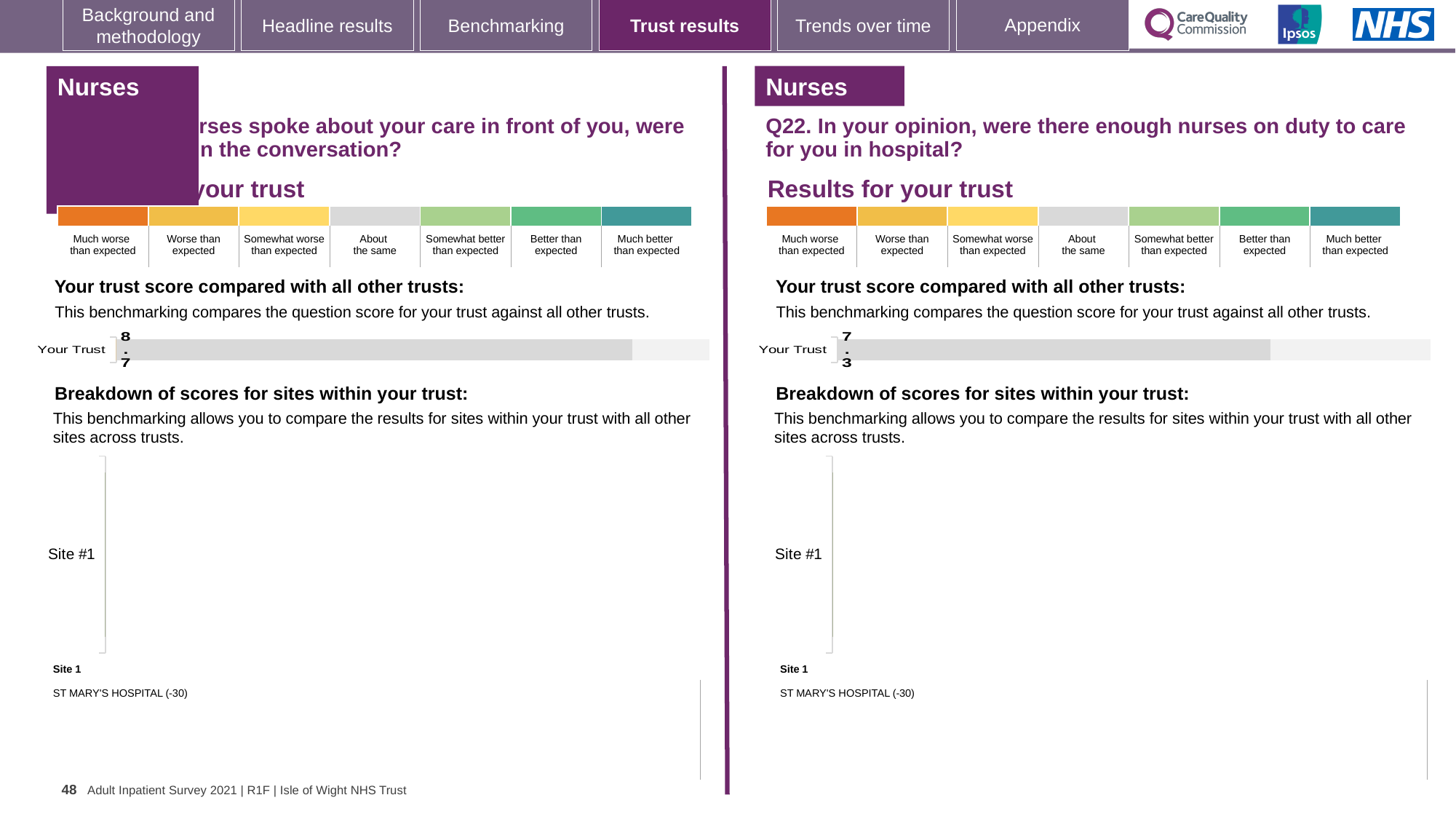
What is the difference between the Your Trust score on the left-hand chart and the Your Trust score on the right-hand Q22 chart? 1.4 How many rating categories are shown in the colour scale above the right-hand Q22 chart? 7 On the right-hand chart for Q22, what is the score shown for Your Trust? 7.3 What kind of chart is used to show the Your Trust score on the right-hand Q22 section? Bar chart What is the category label of the single bar in the left-hand 'Your trust score compared with all other trusts' chart? Your Trust How many bars are plotted in the 'Your trust score compared with all other trusts' chart on the right-hand Q22 section? 1 Which trust score is larger: the one on the left-hand chart or the one on the right-hand Q22 chart? The left-hand chart (8.7) Is the Your Trust score on the right-hand Q22 chart greater or less than 8? less On the left-hand 'Your trust score compared with all other trusts' chart, what is the score shown for Your Trust? 8.7 Is the Your Trust score on the left-hand chart greater or less than 8? greater